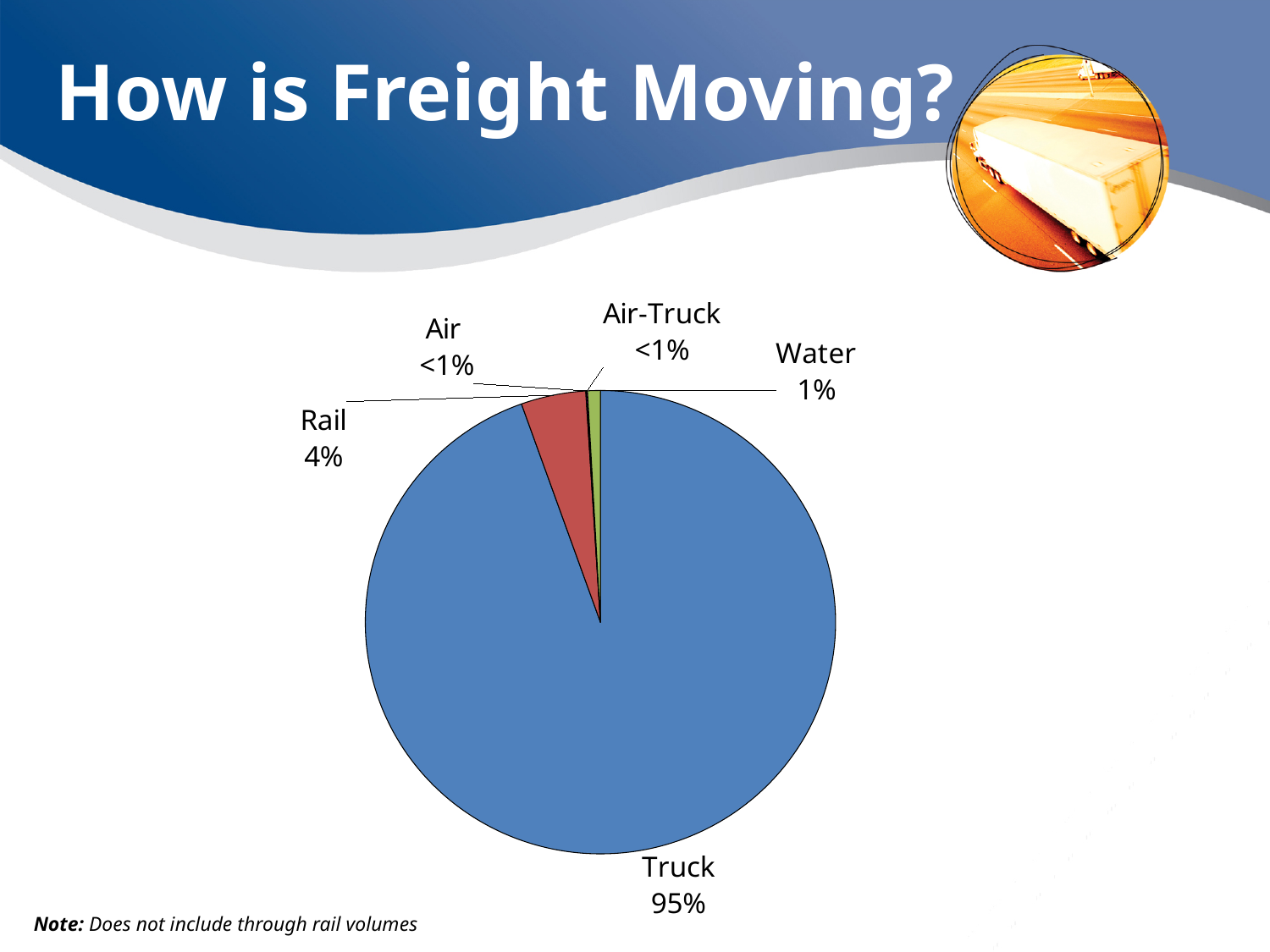
What share is shown for Air-Truck? <1% How many slices (modes) are labelled on the pie chart? 5 What share of freight moves by Rail? 4% What share is shown for Air? <1% What does the note below the chart say is not included? through rail volumes Which is larger, the share for Rail or the share for Water? Rail What kind of chart is shown on the slide? pie chart What share of freight moves by Truck? 95% What is the title of the slide containing the chart? How is Freight Moving? What is the difference between the Truck share and the Rail share? 91% Which mode has the largest share of the pie? Truck What share of freight moves by Water? 1%